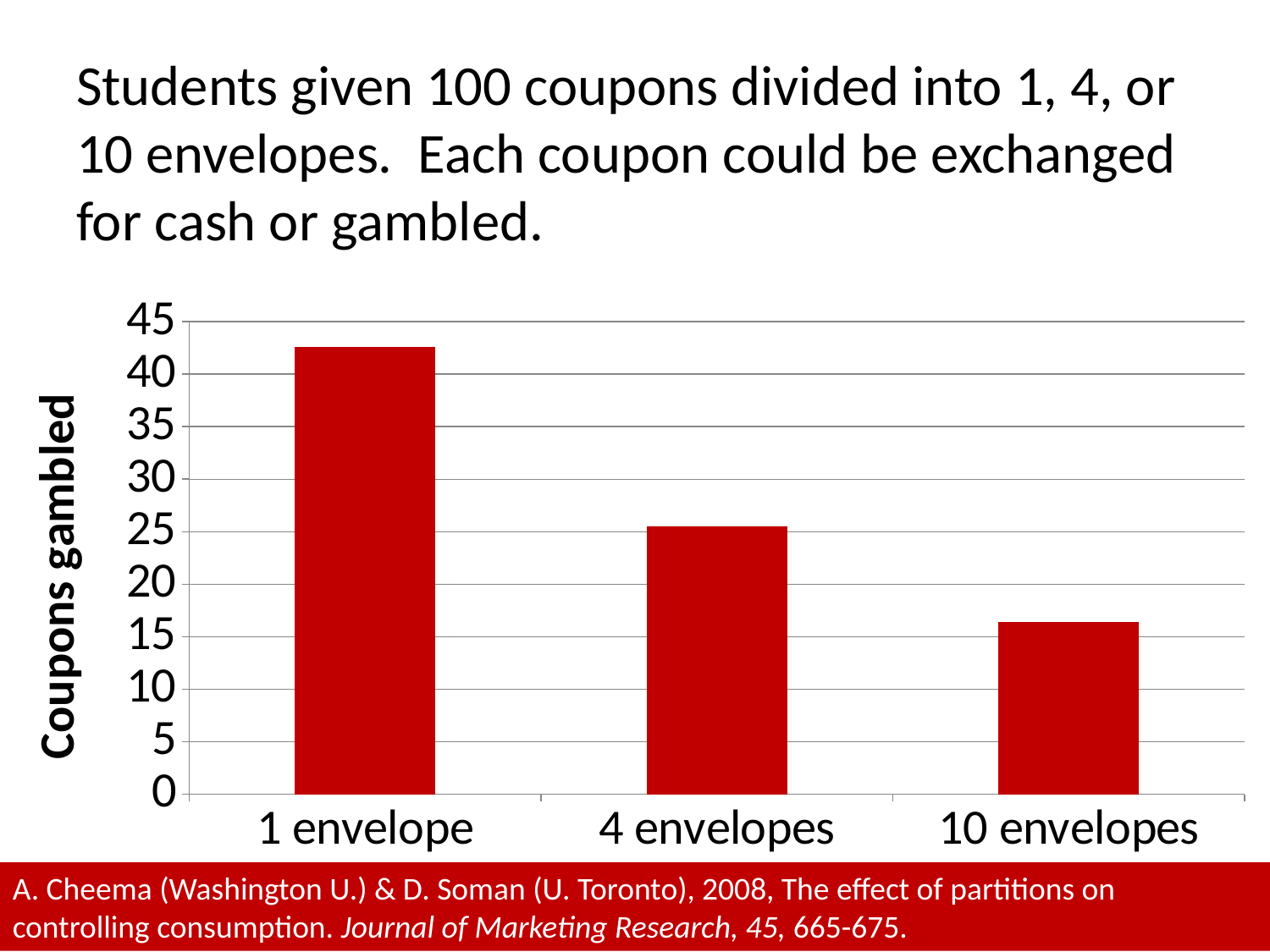
Is the value for 4 envelopes greater or less than 30? less Is the value for 10 envelopes greater or less than 15? greater Is the value for 10 envelopes greater or less than 20? less Which category has the highest number of coupons gambled? 1 envelope Which category has the lowest number of coupons gambled? 10 envelopes What is the label on the vertical axis of the chart? Coupons gambled How many categories are plotted on the x axis of the chart? 3 Which is larger, the value for 4 envelopes or the value for 10 envelopes? 4 envelopes What kind of chart is shown on the slide? bar chart What colour are the bars in the chart? red Do the values rise or fall as the number of envelopes increases along the x axis? fall